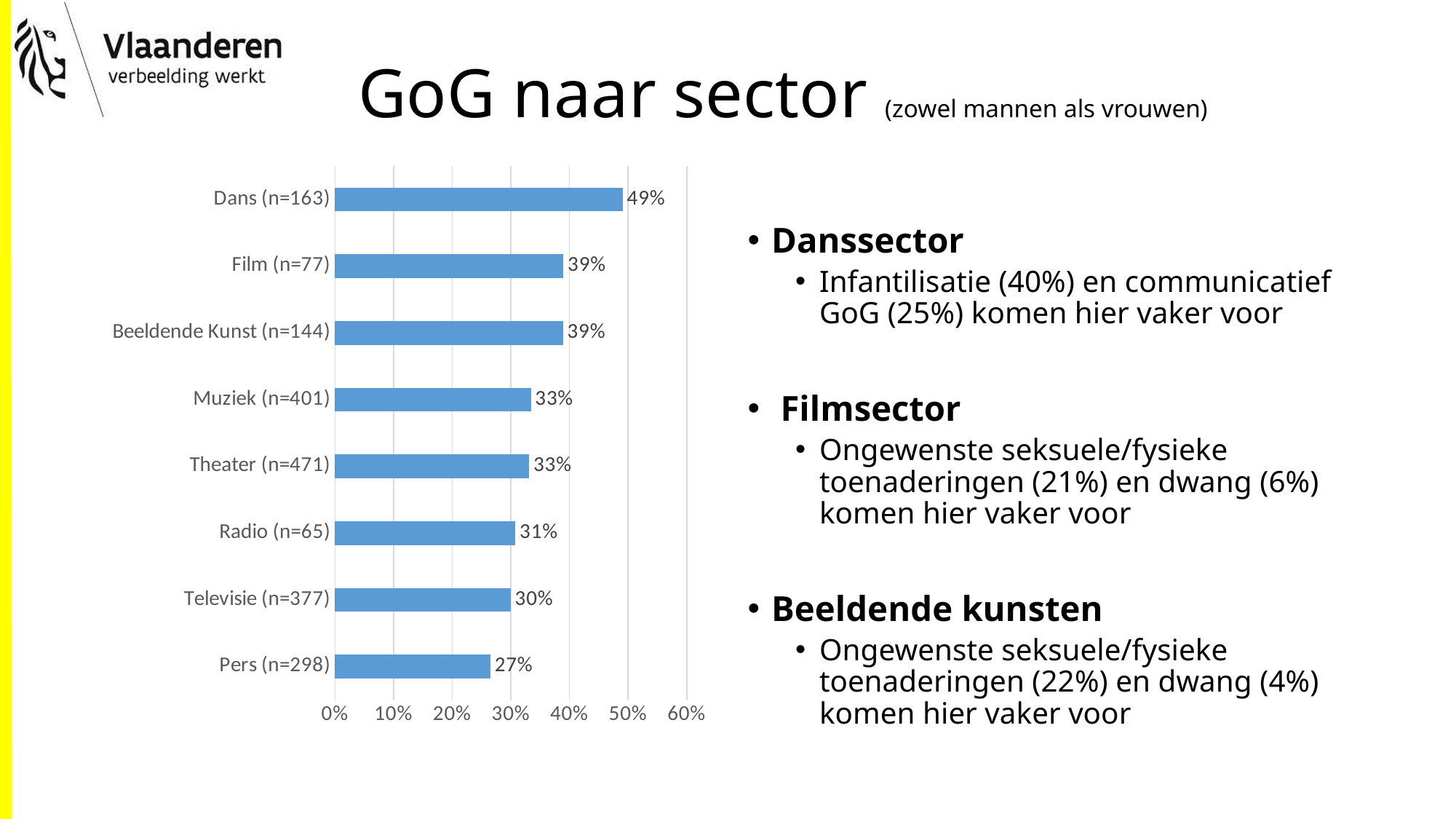
What is the difference between the values for Dans (n=163) and Pers (n=298)? 22% What is the value for Radio (n=65)? 31% How many sectors are shown in the chart? 8 Which sector has the highest value? Dans (n=163) Is the value for Televisie (n=377) greater or less than 40%? less Which is larger, the value for Film (n=77) or the value for Muziek (n=401)? Film (n=77) What is the value for Pers (n=298)? 27% What kind of chart is shown on the slide? bar chart What is the value for Dans (n=163)? 49% Which sector has the lowest value? Pers (n=298) What is the highest value shown on the x axis of the chart? 60% What is the difference between the values for Beeldende Kunst (n=144) and Theater (n=471)? 6%